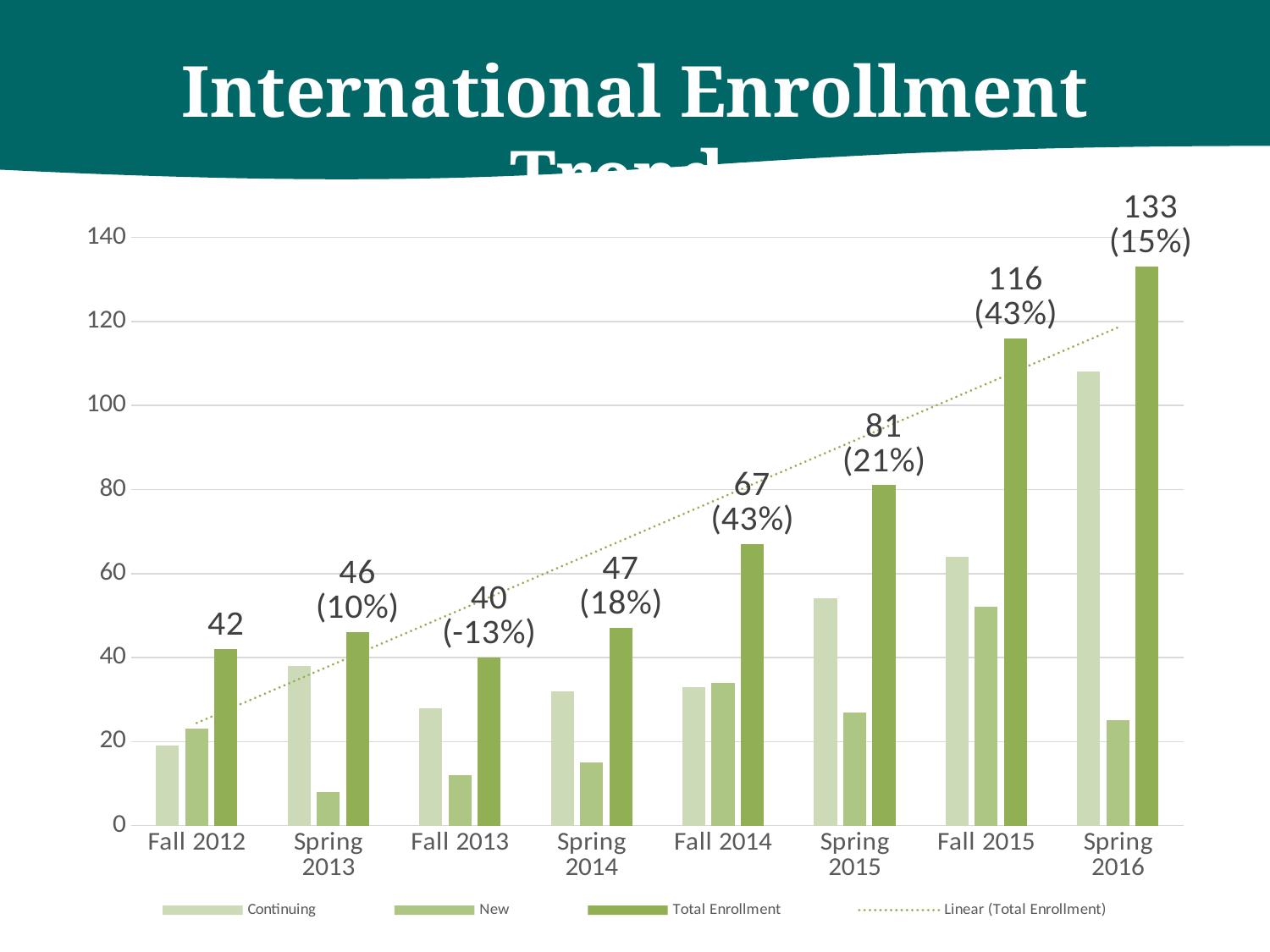
How many terms are shown on the x axis? 8 What is the difference in Total Enrollment between Spring 2016 and Fall 2015? 17 What percentage change is shown next to the Total Enrollment value for Fall 2013? -13% Is the Continuing value for Spring 2016 greater or less than 100? greater What is the Total Enrollment value for Fall 2012? 42 Does Total Enrollment rise or fall from Fall 2014 to Spring 2016? rise Which term has the highest Total Enrollment? Spring 2016 How many entries does the legend list? 4 What is the Total Enrollment value for Spring 2016? 133 Is the New value for Spring 2013 greater or less than 20? less Which is larger, the Total Enrollment for Fall 2014 or for Spring 2015? Spring 2015 Which term has the lowest Total Enrollment? Fall 2013